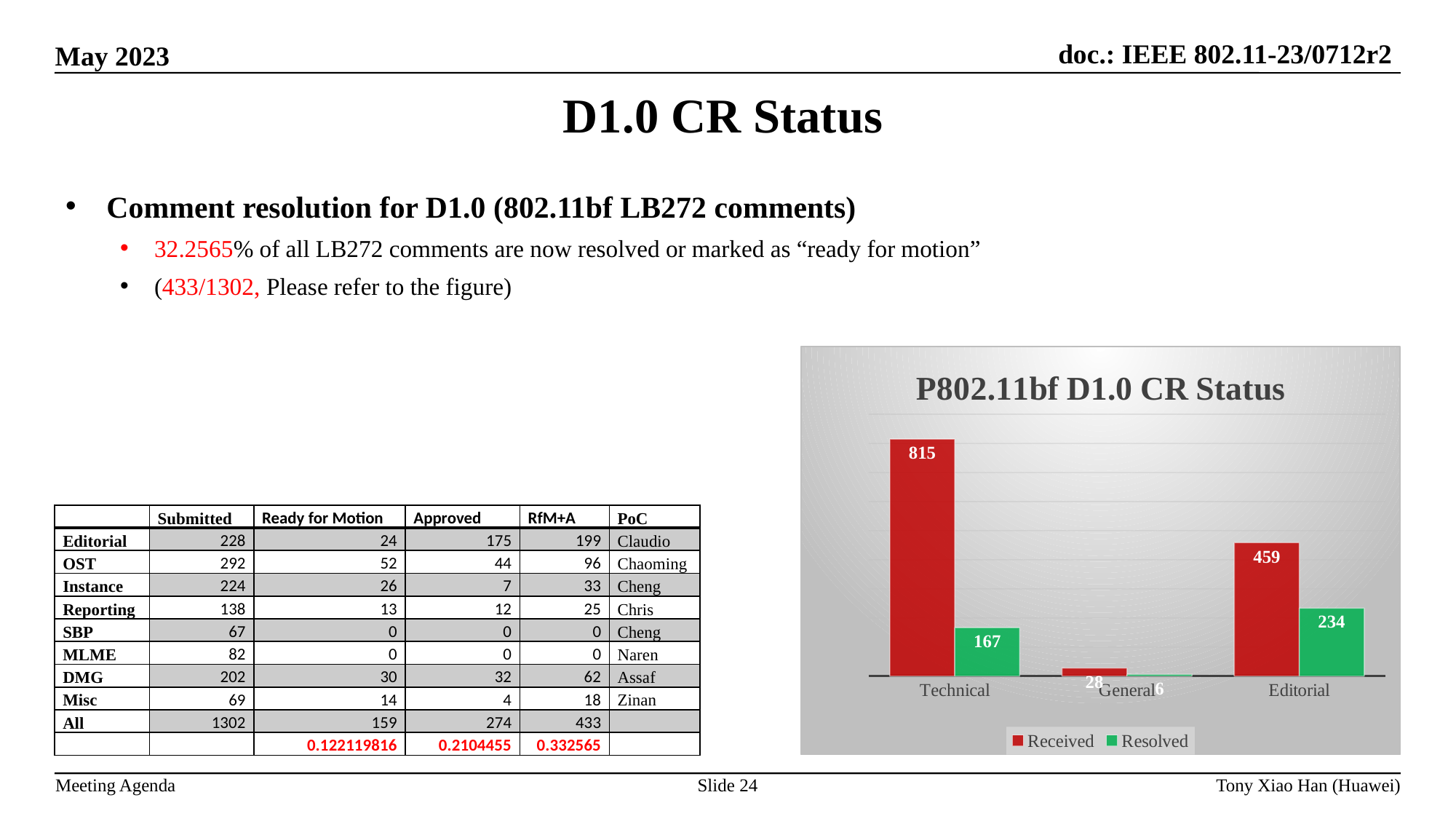
What is the difference between the Received and Resolved values for Editorial in the chart? 225 Which category has the highest Received value in the chart? Technical What is the Resolved value for Editorial in the chart? 234 How many categories are shown on the x axis of the chart? 3 Which category has the lowest Resolved value in the chart? General What is the title of the chart on the slide? P802.11bf D1.0 CR Status How many series does the chart legend list? 2 What is the Received value for Technical in the chart? 815 What is the Received value for General in the chart? 28 What type of chart is shown on the slide? bar chart What is the Resolved value for Technical in the chart? 167 Which is larger in the chart: the Resolved value for Editorial or the Resolved value for Technical? Editorial